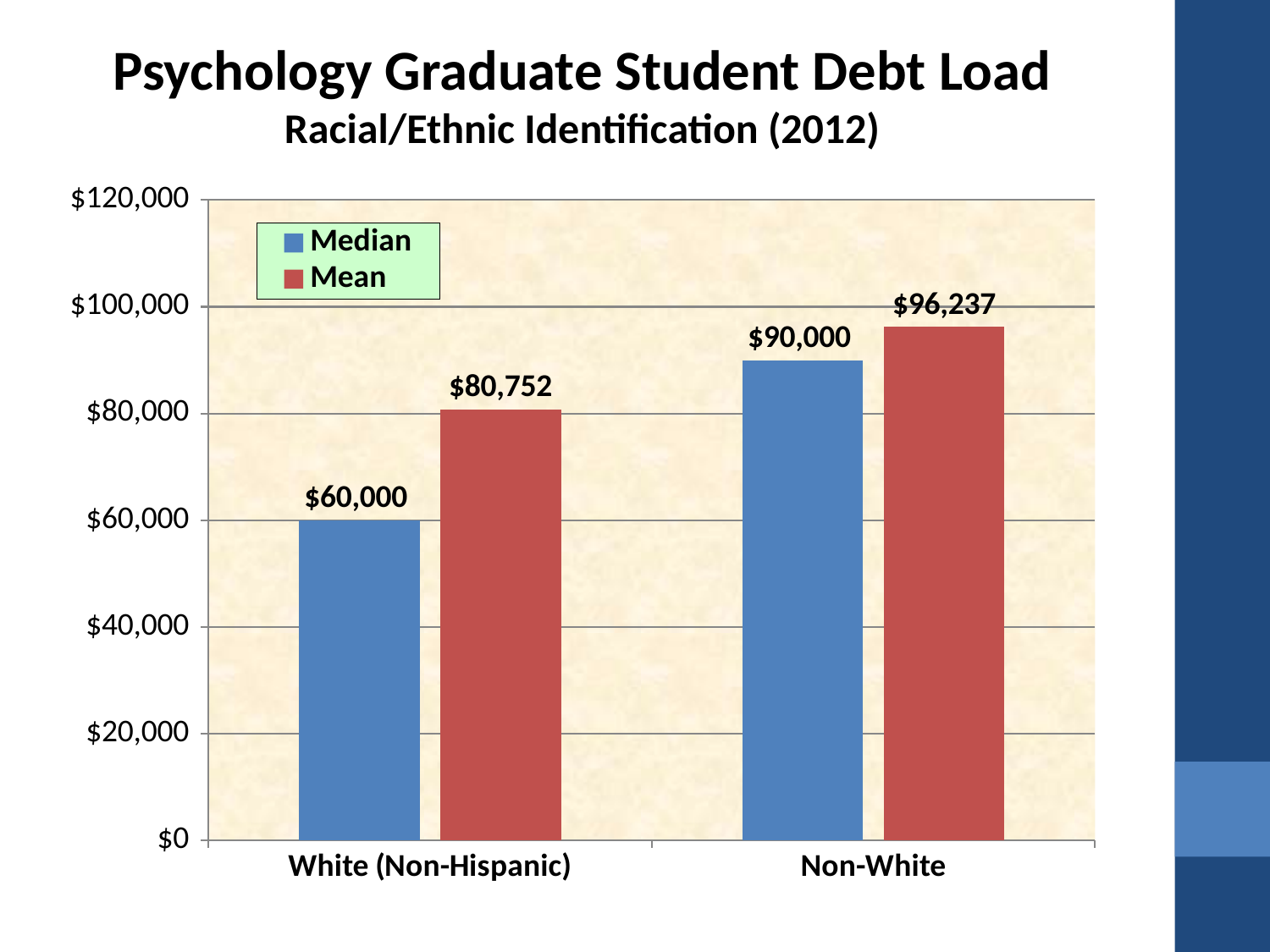
What kind of chart is shown on the slide? Bar chart Is the mean debt load for White (Non-Hispanic) students greater or less than $100,000? less Which bar shows the lowest value on the chart? White (Non-Hispanic) Median What is the difference between the mean and median debt load for Non-White students? $6,237 Which colour represents the Mean series in the legend? Red What is the mean debt load for Non-White psychology graduate students? $96,237 What is the median debt load for Non-White students? $90,000 How many series does the legend list? 2 What is the median debt load for White (Non-Hispanic) psychology graduate students? $60,000 Which group has the higher median debt load? Non-White What is the difference between the median debt loads of Non-White and White (Non-Hispanic) students? $30,000 What is the mean debt load for White (Non-Hispanic) students? $80,752